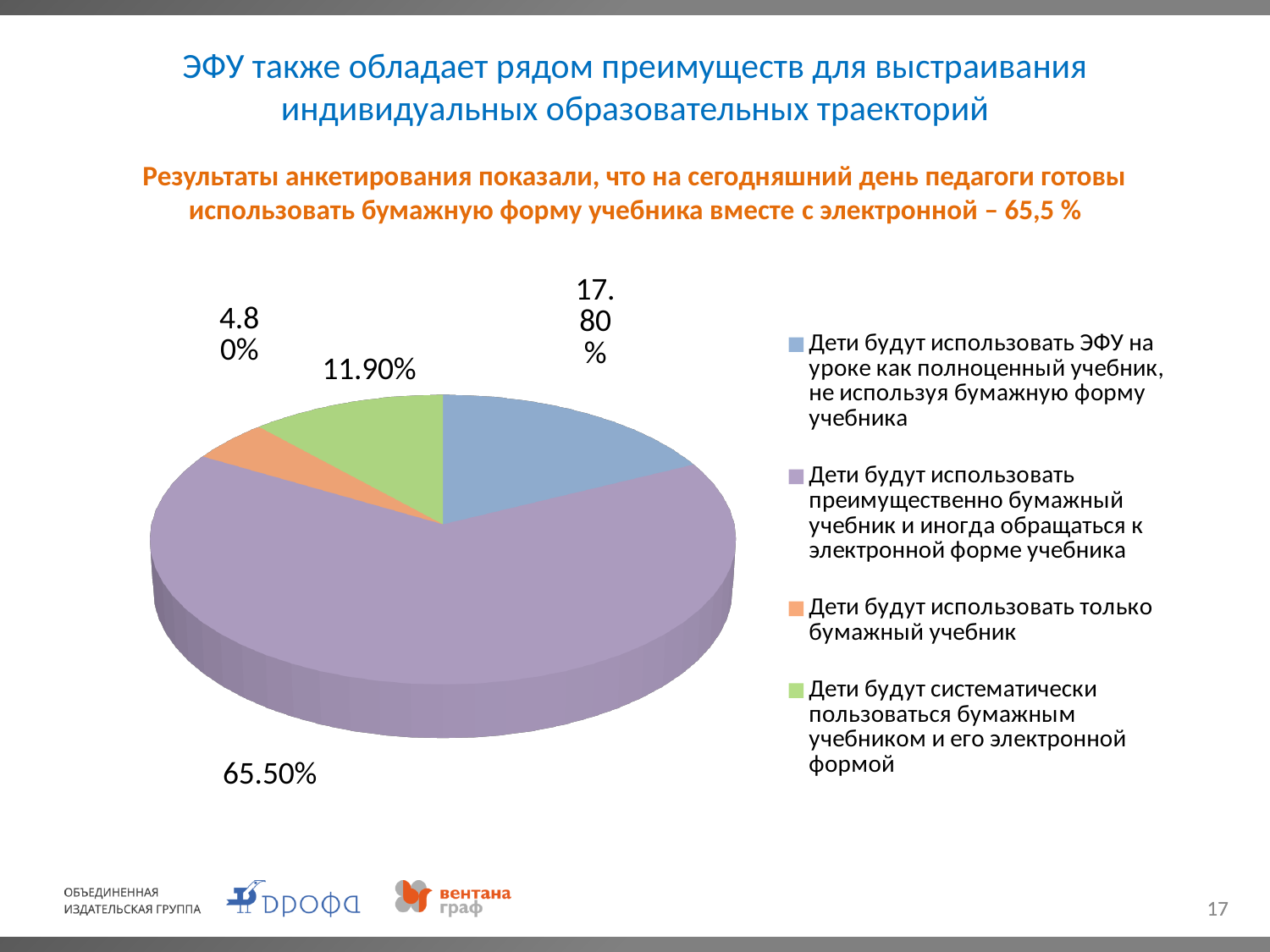
What is the difference in percentage points between the largest slice (65.50%) and the slice for 'Дети будут использовать ЭФУ на уроке как полноценный учебник, не используя бумажную форму учебника' (17.80%)? 47.70 How many slices does the pie chart have? 4 What share of the pie is labelled for 'Дети будут использовать только бумажный учебник'? 4.80% How many entries does the legend of the pie chart list? 4 Which category has the smallest slice of the pie? Дети будут использовать только бумажный учебник What colour is the slice representing 'Дети будут использовать только бумажный учебник'? orange Which is larger: the slice for 'Дети будут систематически пользоваться бумажным учебником и его электронной формой' or the slice for 'Дети будут использовать только бумажный учебник'? Дети будут систематически пользоваться бумажным учебником и его электронной формой Which category has the largest slice of the pie? Дети будут использовать преимущественно бумажный учебник и иногда обращаться к электронной форме учебника What share of the pie is labelled for 'Дети будут использовать ЭФУ на уроке как полноценный учебник, не используя бумажную форму учебника'? 17.80% What share of the pie is labelled for 'Дети будут использовать преимущественно бумажный учебник и иногда обращаться к электронной форме учебника'? 65.50% What kind of chart is shown on the slide? pie chart What share of the pie is labelled for 'Дети будут систематически пользоваться бумажным учебником и его электронной формой'? 11.90%